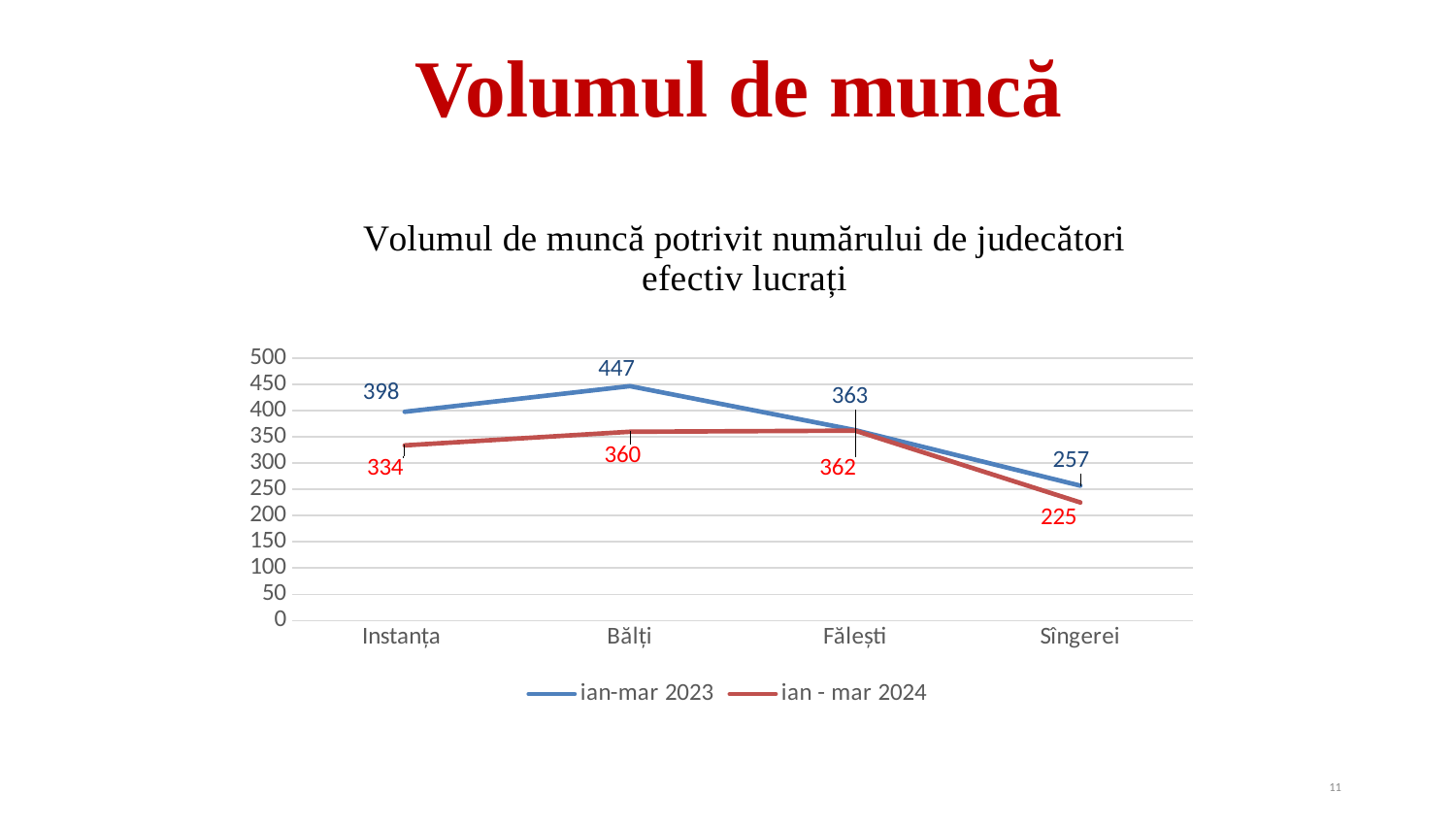
What kind of chart is shown on the slide? line chart What is the difference between the ian-mar 2023 and ian - mar 2024 values for Instanța? 64 How many categories are shown on the x axis? 4 Which is larger for Sîngerei: the ian-mar 2023 value or the ian - mar 2024 value? ian-mar 2023 What is the title of the chart? Volumul de muncă potrivit numărului de judecători efectiv lucrați What is the value for Bălți in the ian-mar 2023 series? 447 Which category has the lowest value in the ian - mar 2024 series? Sîngerei What is the value for Instanța in the ian - mar 2024 series? 334 What is the value for Sîngerei in the ian - mar 2024 series? 225 What is the difference between the ian-mar 2023 and ian - mar 2024 values for Bălți? 87 Which category has the highest value in the ian-mar 2023 series? Bălți How many series does the legend list? 2